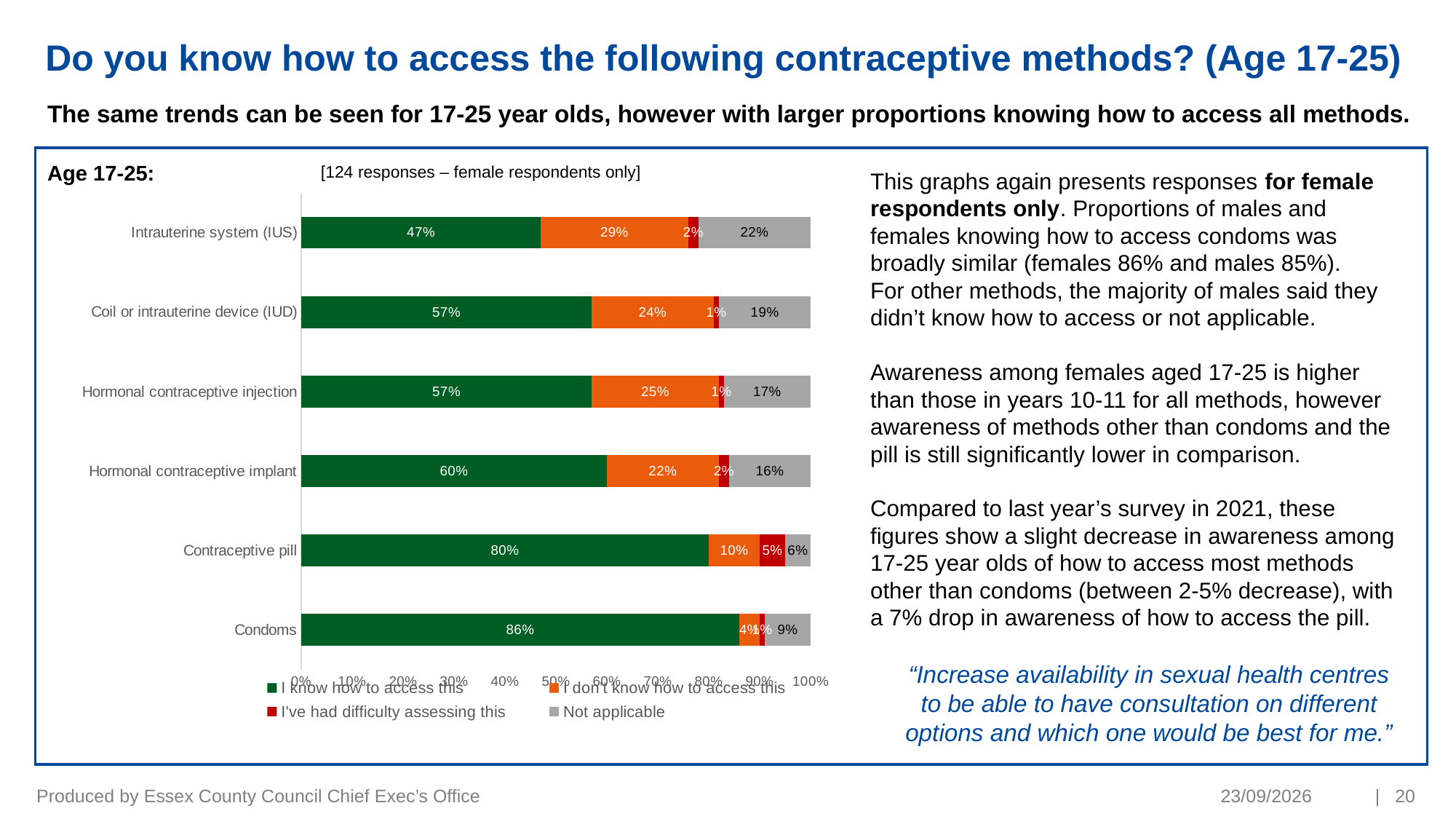
What type of chart is shown on the slide? Stacked bar chart What percentage of respondents said they know how to access the intrauterine system (IUS)? 47% How many contraceptive methods are shown on the chart? 6 What is the 'Not applicable' value for the contraceptive pill? 6% What percentage of respondents said they know how to access condoms? 86% Which has a larger 'I don't know how to access this' value: the intrauterine system (IUS) or the hormonal contraceptive implant? Intrauterine system (IUS) How many series does the chart legend list? 4 Which series is shown in grey on the chart? Not applicable What is the difference between the 'I know how to access this' values for condoms and the contraceptive pill? 6% Which contraceptive method has the lowest proportion of respondents who know how to access it? Intrauterine system (IUS) What percentage of respondents said they don't know how to access the hormonal contraceptive injection? 25% Which contraceptive method has the highest proportion of respondents who know how to access it? Condoms